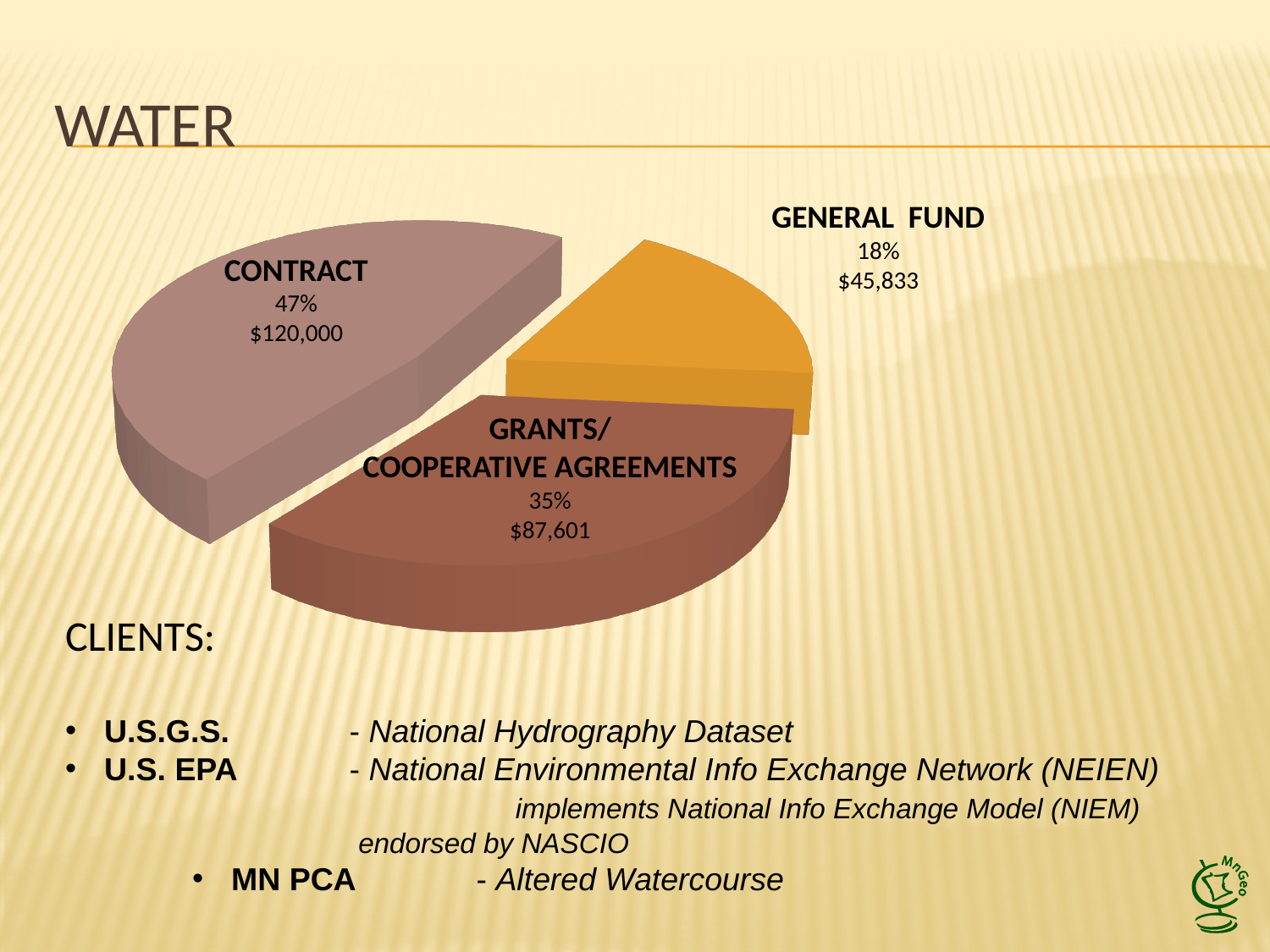
What is the difference in dollars between CONTRACT and GENERAL FUND? $74,167 What is the dollar value for CONTRACT? $120,000 Which category has the largest slice? CONTRACT What is the dollar value for GRANTS/COOPERATIVE AGREEMENTS? $87,601 What is the dollar value for GENERAL FUND? $45,833 What share of the pie does GRANTS/COOPERATIVE AGREEMENTS represent? 35% Which is larger, GRANTS/COOPERATIVE AGREEMENTS or GENERAL FUND? GRANTS/COOPERATIVE AGREEMENTS What kind of chart is shown on the slide? pie chart What share of the pie does CONTRACT represent? 47% What share of the pie does GENERAL FUND represent? 18% Which category has the smallest slice? GENERAL FUND How many slices does the pie chart have? 3